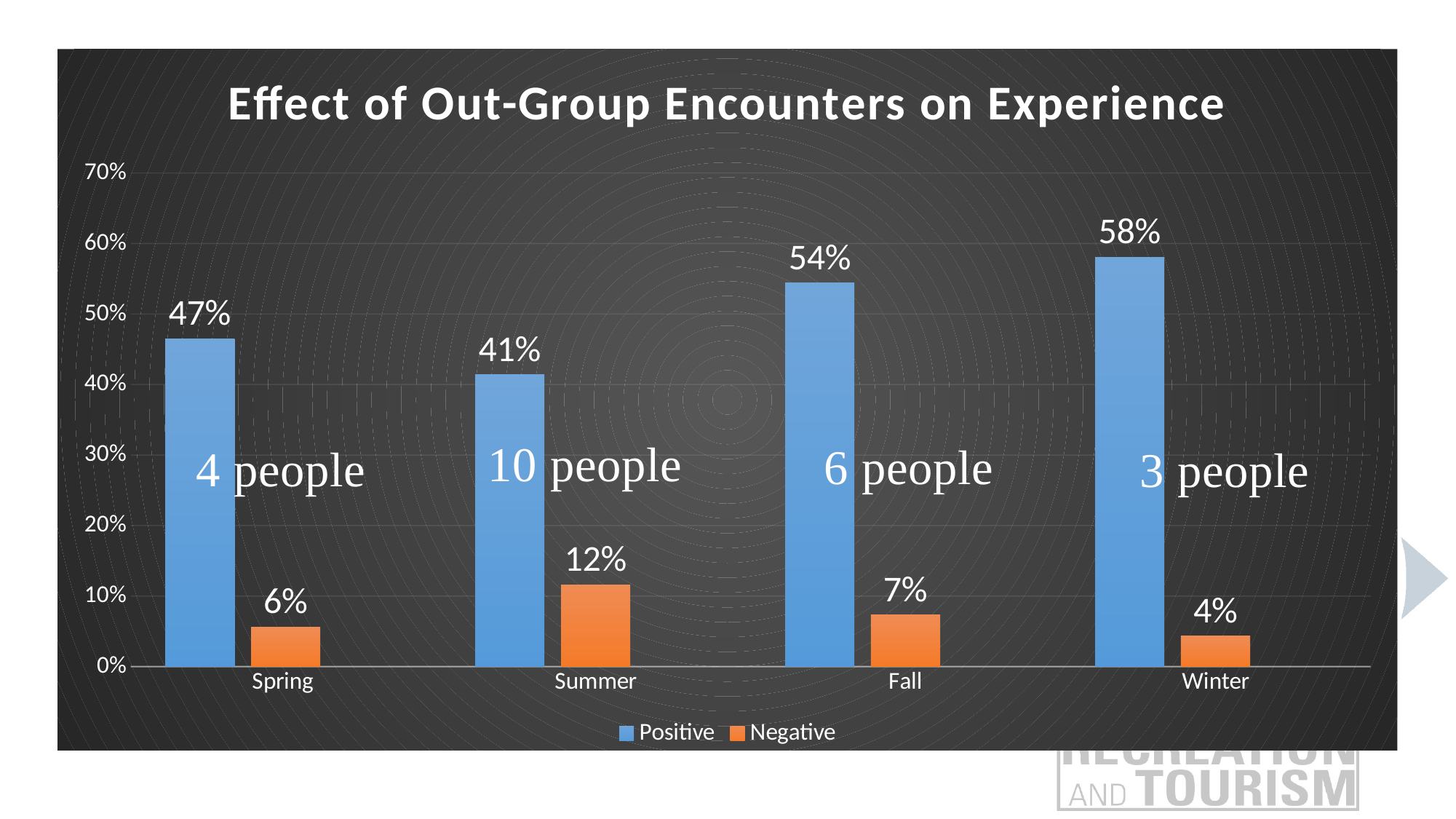
What colour are the Negative bars? Orange What is the title of the chart? Effect of Out-Group Encounters on Experience How many series does the legend list? 2 What is the Positive value for Spring? 47% Which season has the lowest Negative value? Winter Which is larger, the Positive value for Summer or the Positive value for Spring? Spring What is the difference between the Positive and Negative values for Fall? 47% What kind of chart is shown? Bar chart What is the Positive value for Fall? 54% What is the Negative value for Summer? 12% How many seasons are shown on the x axis? 4 Which season has the highest Positive value? Winter